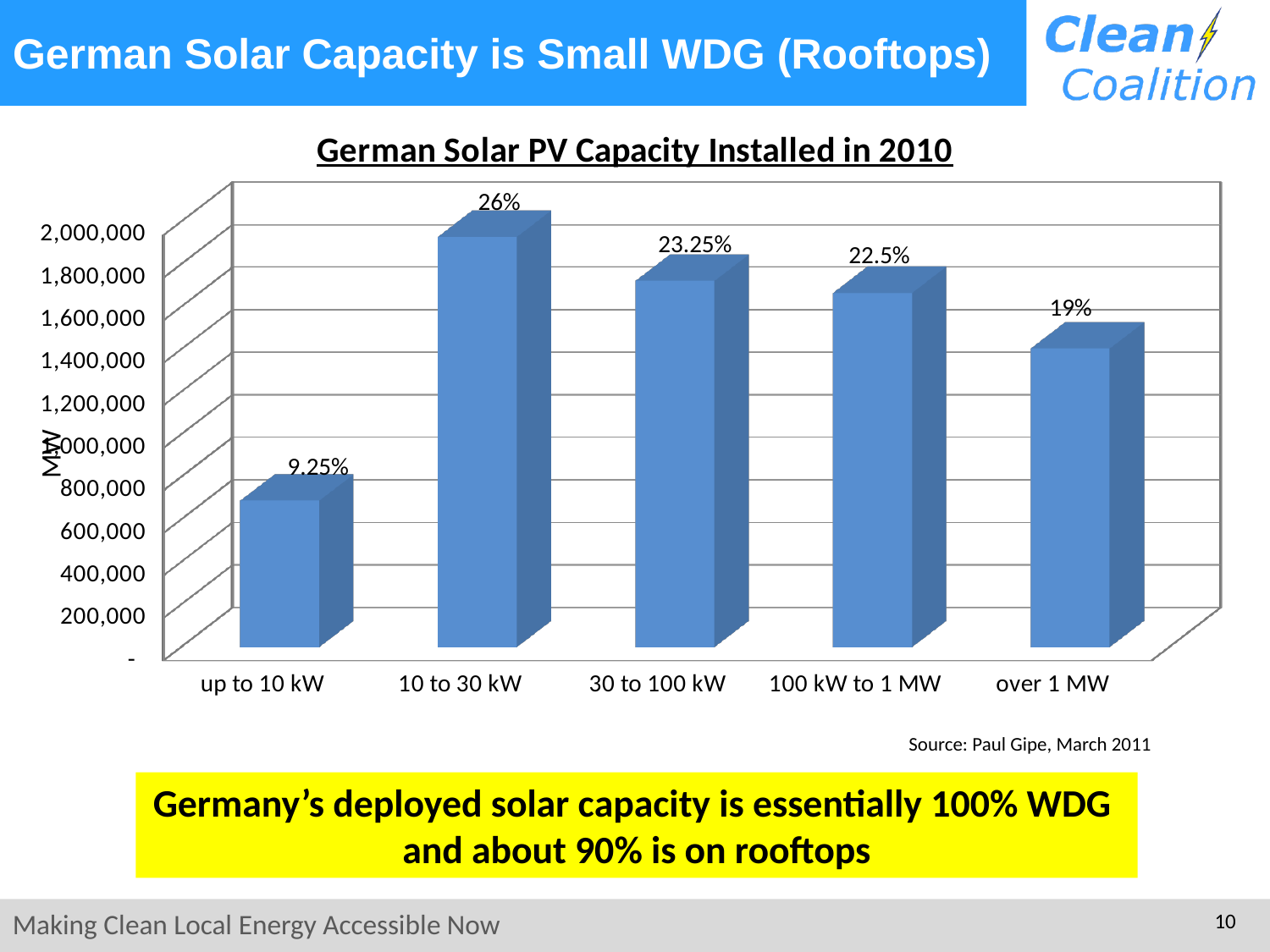
Which has the larger data label, '30 to 100 kW' or '100 kW to 1 MW'? 30 to 100 kW What type of chart is shown on the slide? Bar chart What is the difference between the data labels for '10 to 30 kW' and 'over 1 MW'? 7% Which category has the tallest bar? 10 to 30 kW Is the value for 'up to 10 kW' greater or less than 1,000,000 MW? less How many categories are shown on the x axis? 5 Which category has the shortest bar? up to 10 kW What is the data label shown on the bar for '10 to 30 kW'? 26% What is the data label shown on the bar for 'up to 10 kW'? 9.25% What is the data label shown on the bar for 'over 1 MW'? 19% What is the data label shown on the bar for '30 to 100 kW'? 23.25% Is the value for '10 to 30 kW' greater or less than 1,600,000 MW? greater